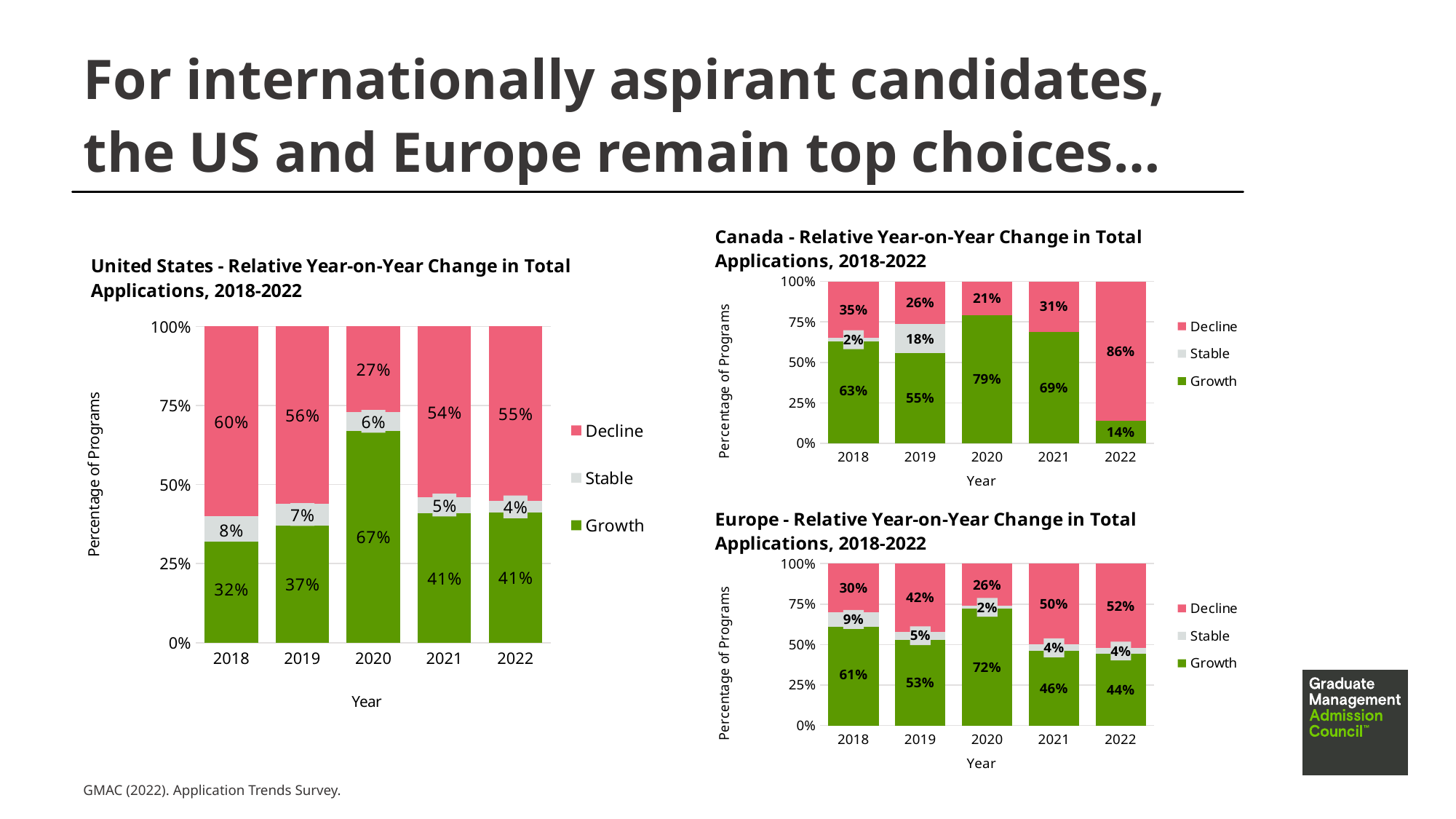
In the Europe chart, what percentage of programs reported Stable applications in 2018? 9% How many years are shown on the x axis of the Europe chart? 5 What type of chart is the Canada chart? Stacked bar chart In the Europe chart, does the Decline percentage rise or fall from 2020 to 2022? Rise In the United States chart, what percentage of programs reported Growth in 2020? 67% In the Canada chart, what percentage of programs reported Decline in 2022? 86% How many series does the legend of the United States chart list? 3 In the Canada chart, which year has the lowest Growth percentage? 2022 In the Canada chart, is the Growth value for 2020 greater or less than 75%? greater In the United States chart, which year has the highest Growth percentage? 2020 In the Europe chart, what is the difference between the Decline percentage in 2022 and in 2018? 22% In the United States chart, which is larger: the Decline percentage in 2018 or in 2019? 2018